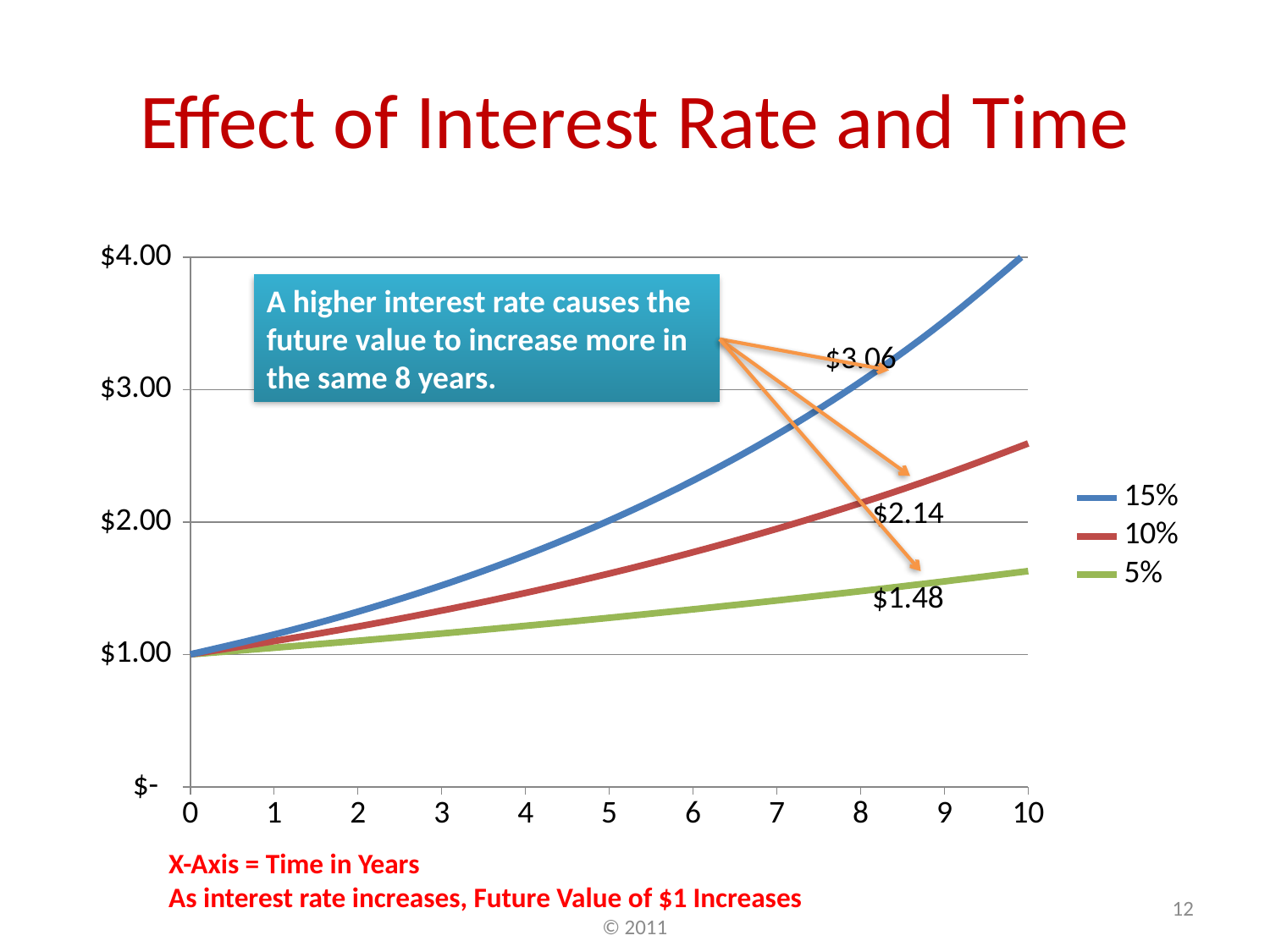
Is the value of the 5% line at year 10 greater or less than $2.00? less What is the labelled value of the 5% line at year 8? $1.48 At year 8, which interest rate line has the highest labelled value? 15% What is the labelled value of the 10% line at year 8? $2.14 What is the difference between the labelled values of the 15% and 10% lines at year 8? $0.92 What kind of chart is shown on the slide? line chart What is the labelled value of the 15% line at year 8? $3.06 Do the values of the 15% line rise or fall as time in years increases? rise At year 8, which interest rate line has the lowest labelled value? 5% Is the value of the 15% line at year 10 greater or less than $3.00? greater What is the difference between the labelled values of the 10% and 5% lines at year 8? $0.66 How many series does the legend list? 3